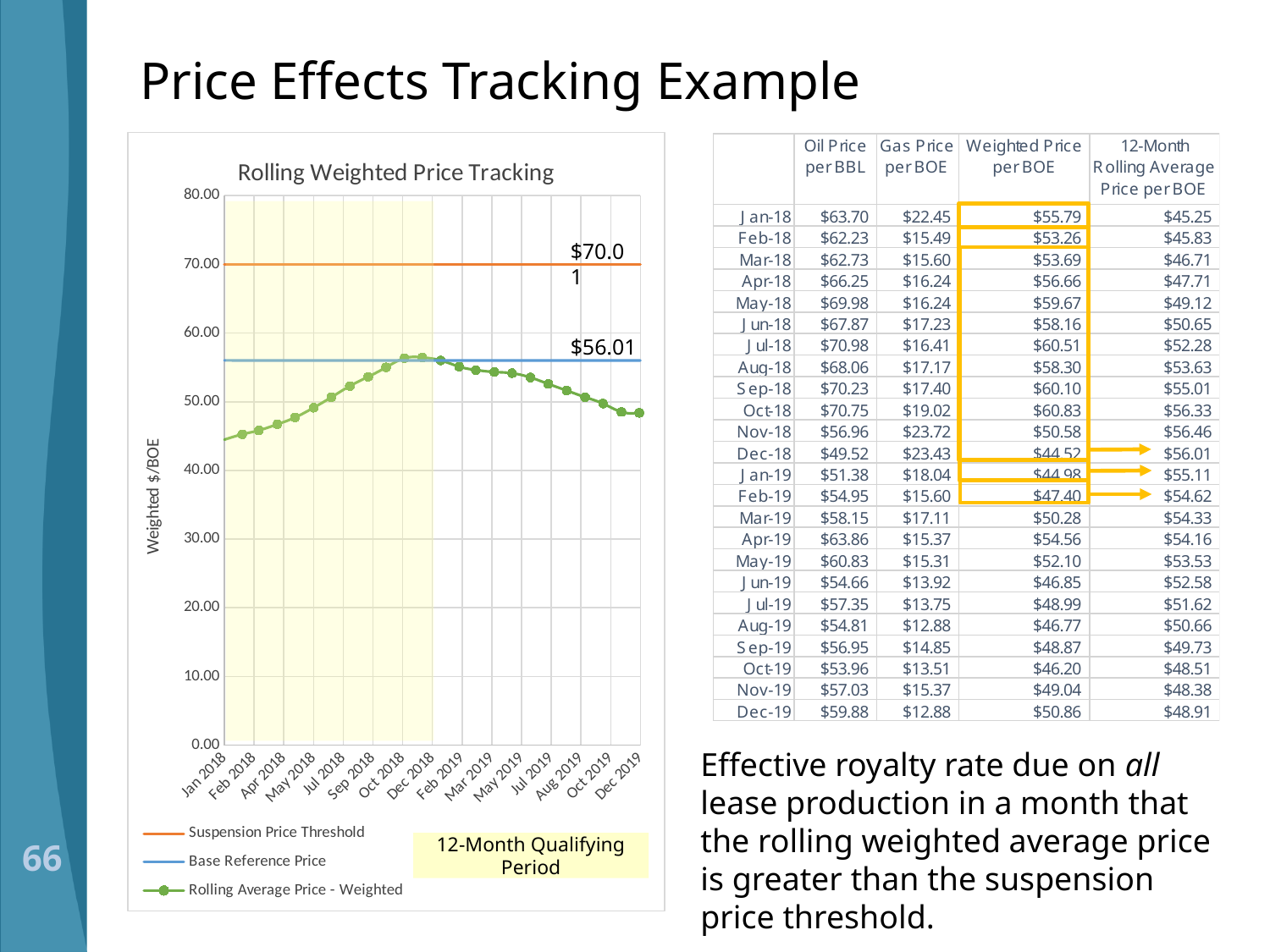
What kind of chart is the Rolling Weighted Price Tracking chart? line chart Which line is higher on the chart, the Suspension Price Threshold or the Base Reference Price? Suspension Price Threshold Is the Rolling Average Price - Weighted value for Jan 2018 greater or less than 50.00? less Does the Rolling Average Price - Weighted line rise or fall from Jan 2018 to Dec 2018? rise Is the Rolling Average Price - Weighted value for Dec 2018 greater or less than 50.00? greater What value is labelled for the Base Reference Price line on the chart? $56.01 How many series does the legend of the Rolling Weighted Price Tracking chart list? 3 Does the Rolling Average Price - Weighted line rise or fall from Jan 2019 to Dec 2019? fall What is the difference between the Suspension Price Threshold ($70.01) and the Base Reference Price ($56.01) on the chart? $14.00 What is the title of the vertical axis on the Rolling Weighted Price Tracking chart? Weighted $/BOE Is the Rolling Average Price - Weighted value for Dec 2019 greater or less than 50.00? less What value is labelled for the Suspension Price Threshold line on the chart? $70.01